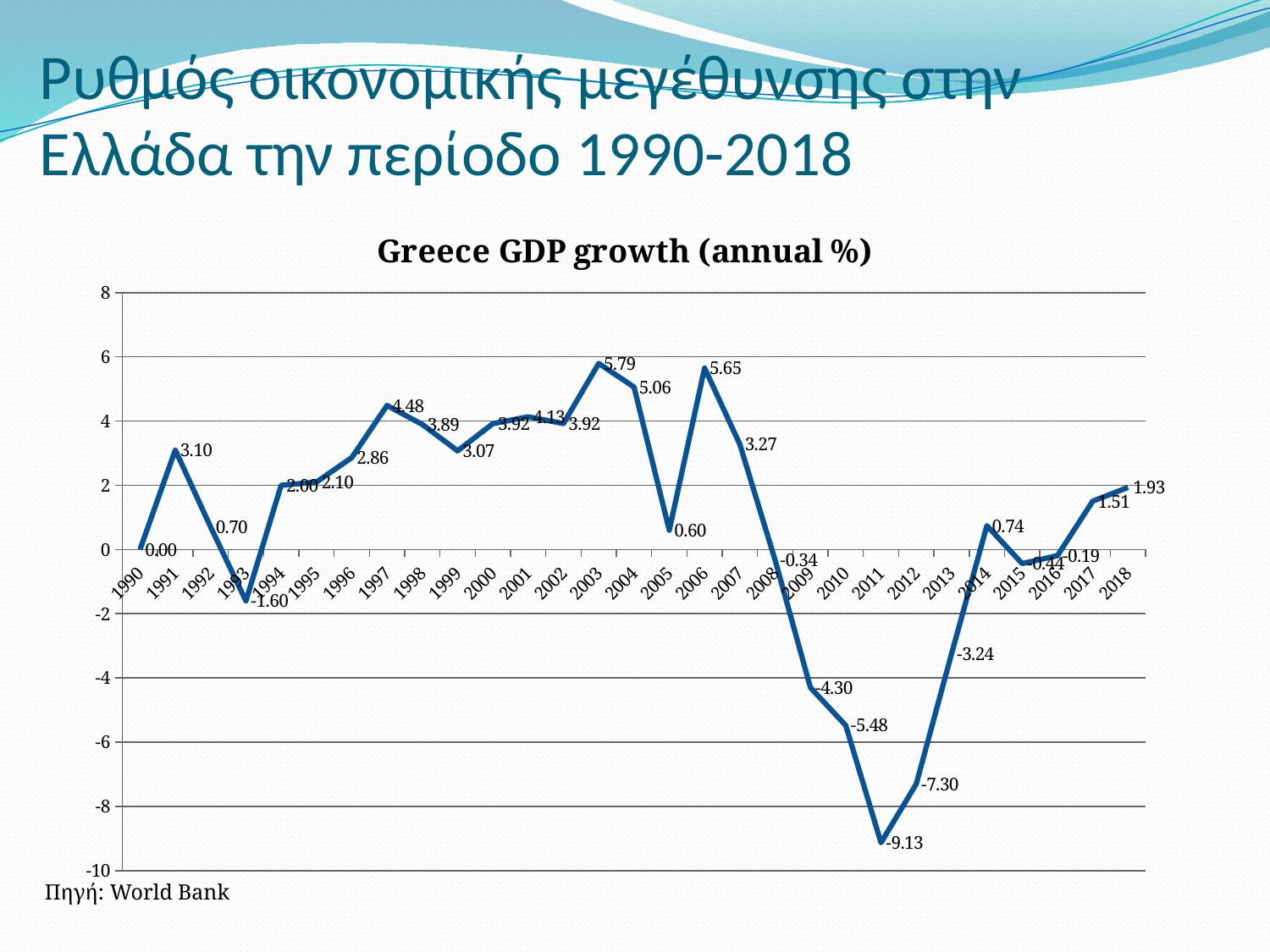
What type of chart is shown on the slide? Line chart What is the GDP growth value for 2003? 5.79 What is the difference between the GDP growth values for 2003 and 2004? 0.73 Which year has a larger GDP growth value, 2006 or 2007? 2006 Do the GDP growth values rise or fall from 2008 to 2011? Fall What is the GDP growth value for 2018? 1.93 How many years (data points) are plotted on the chart? 29 Which year has the highest GDP growth value? 2003 What is the title of the chart? Greece GDP growth (annual %) Which year has the lowest GDP growth value? 2011 What is the GDP growth value for 2011? -9.13 What is the GDP growth value for 1997? 4.48